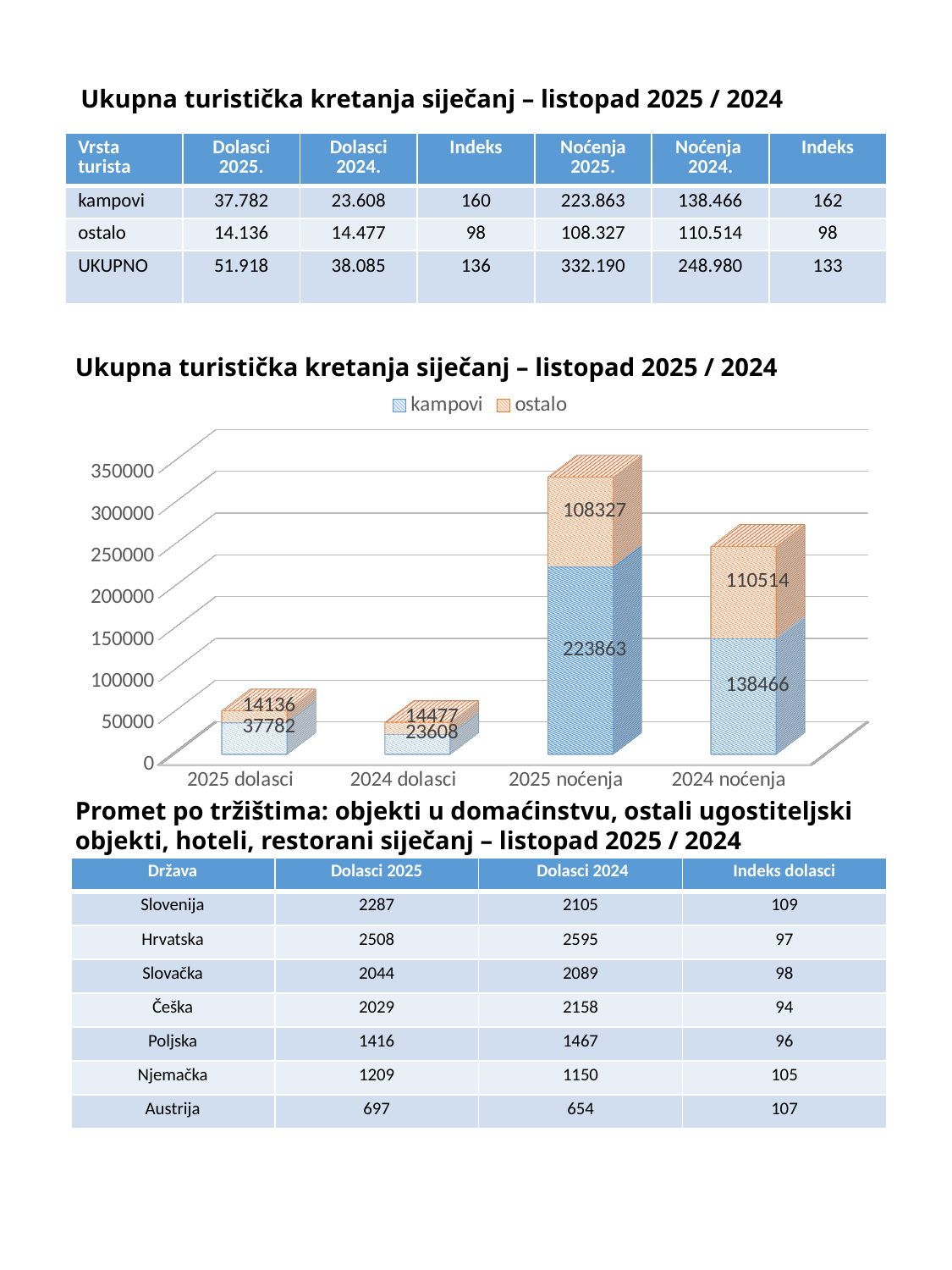
What is the total of the stacked bar for 2025 noćenja in the chart? 332190 What is the value of ostalo for 2024 noćenja in the chart? 110514 How many series does the chart legend list? 2 What is the value of ostalo for 2025 dolasci in the chart? 14136 What is the difference between the kampovi values for 2025 noćenja and 2024 noćenja in the chart? 85397 What is the value of kampovi for 2025 noćenja in the chart? 223863 Which category has the highest kampovi value in the chart? 2025 noćenja How many categories are shown on the x axis of the chart? 4 Which category has the lowest ostalo value in the chart? 2025 dolasci What is the value of kampovi for 2024 dolasci in the chart? 23608 Is the kampovi value for 2024 noćenja greater or less than 100000? greater What kind of chart is shown on the slide? bar chart